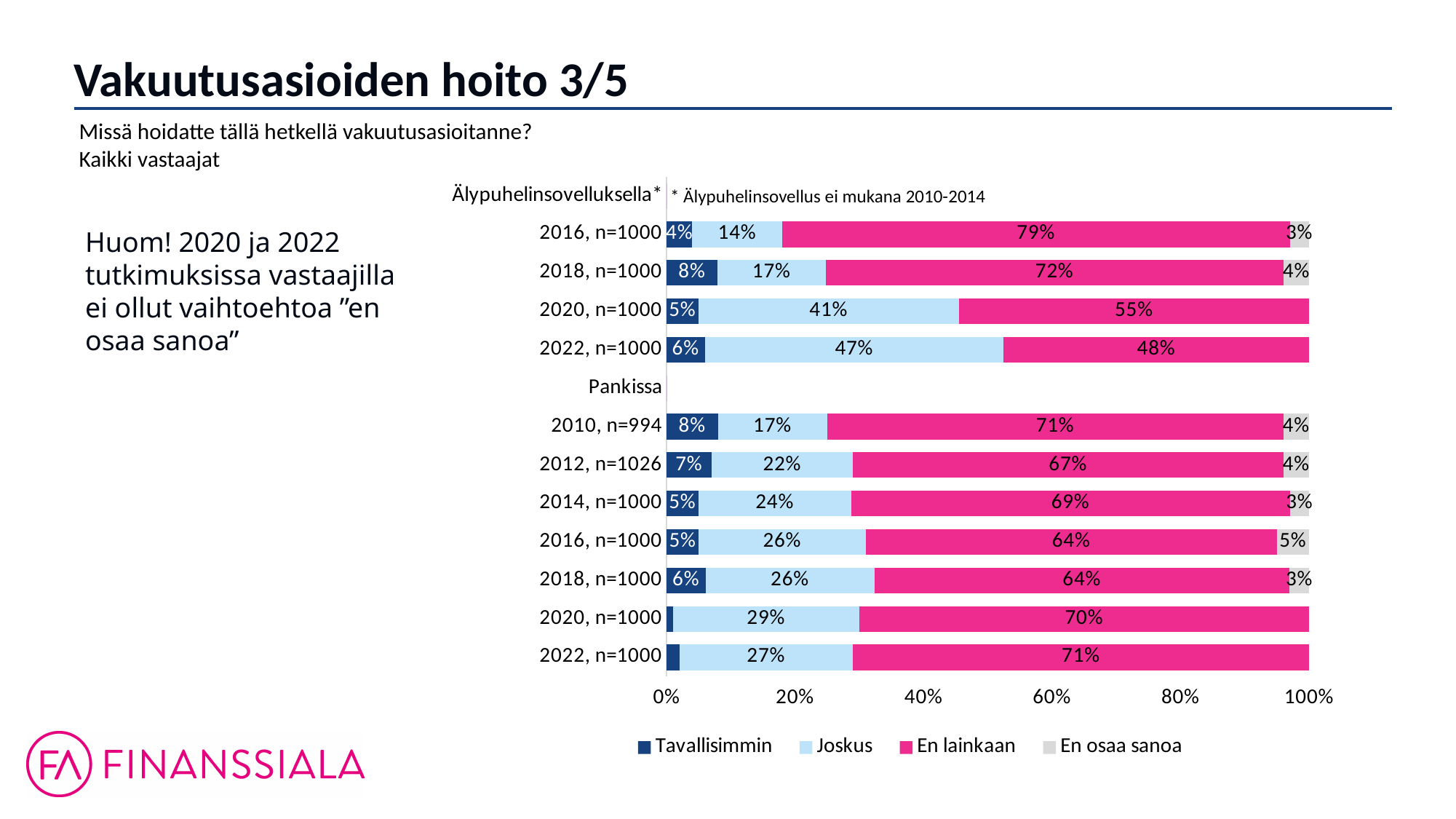
Among the Älypuhelinsovelluksella bars, which year has the highest "En lainkaan" value? 2016, n=1000 What is the value for "En lainkaan" in the Pankissa 2010, n=994 bar? 71% What kind of chart is shown on the slide? Stacked bar chart What is the total of the Älypuhelinsovelluksella 2016, n=1000 stacked bar? 100% How much higher is the "Joskus" value for Älypuhelinsovelluksella in 2022 than in 2016? 33 percentage points Does the "Joskus" value for Älypuhelinsovelluksella rise or fall from 2016 to 2022? Rises What is the value for "En osaa sanoa" in the Pankissa 2016, n=1000 bar? 5% Among the Pankissa bars, which year has the lowest "Joskus" value? 2010, n=994 What is the value for "Joskus" in the Älypuhelinsovelluksella 2022, n=1000 bar? 47% How many series does the legend list? 4 How many bars are shown under the Pankissa group? 7 Which Pankissa bar has the larger "Joskus" value, 2012, n=1026 or 2014, n=1000? 2014, n=1000